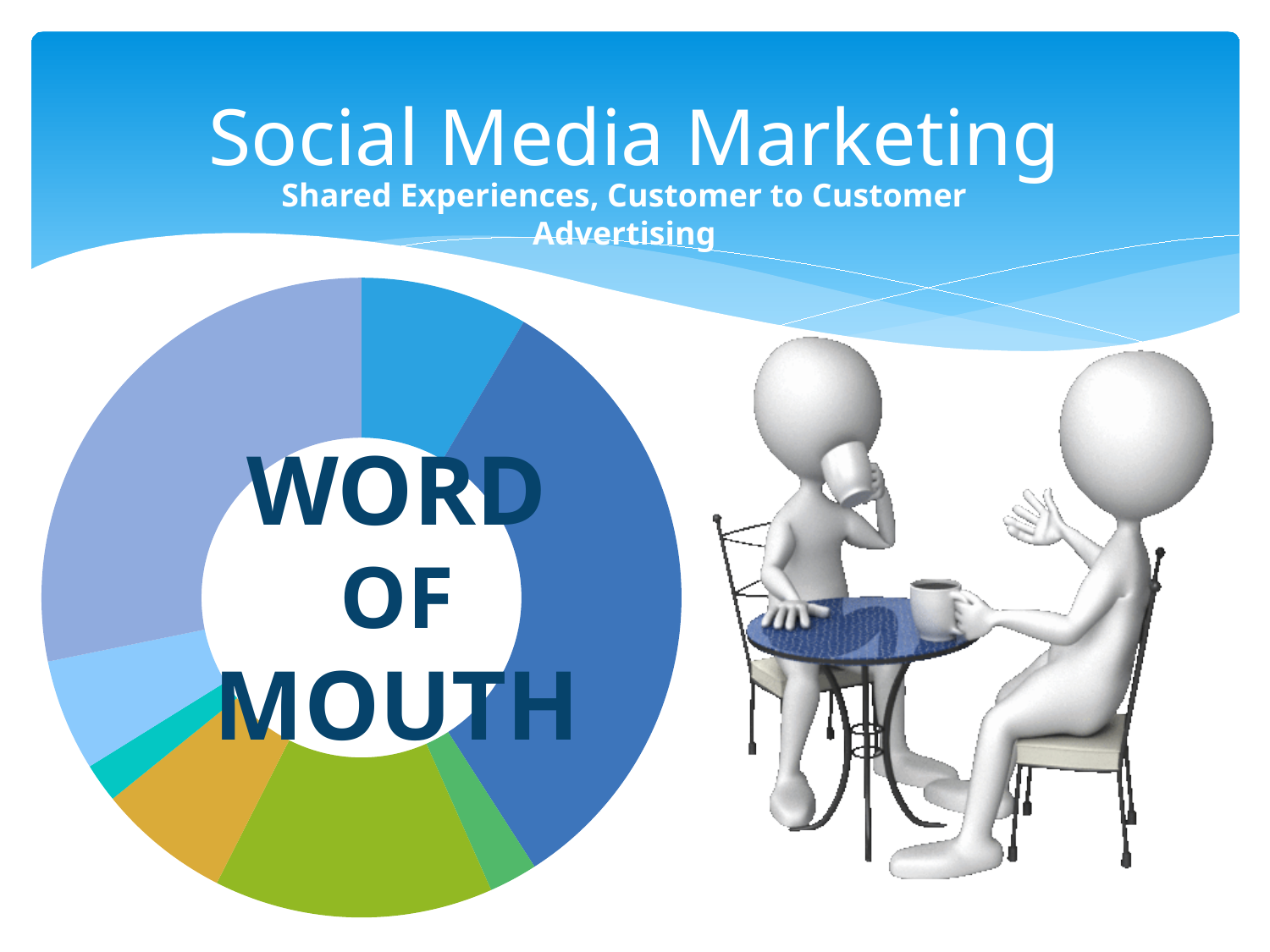
Does the doughnut chart display a legend or data labels? No Which is larger in the doughnut chart, the dark blue slice or the lime green slice? Dark blue Which colour slice is the largest in the doughnut chart? Dark blue How many slices does the doughnut chart contain? 8 What text appears in the centre of the doughnut chart? WORD OF MOUTH What kind of chart is shown on the left of the slide? Doughnut chart Which is larger in the doughnut chart, the lavender slice or the gold slice? Lavender